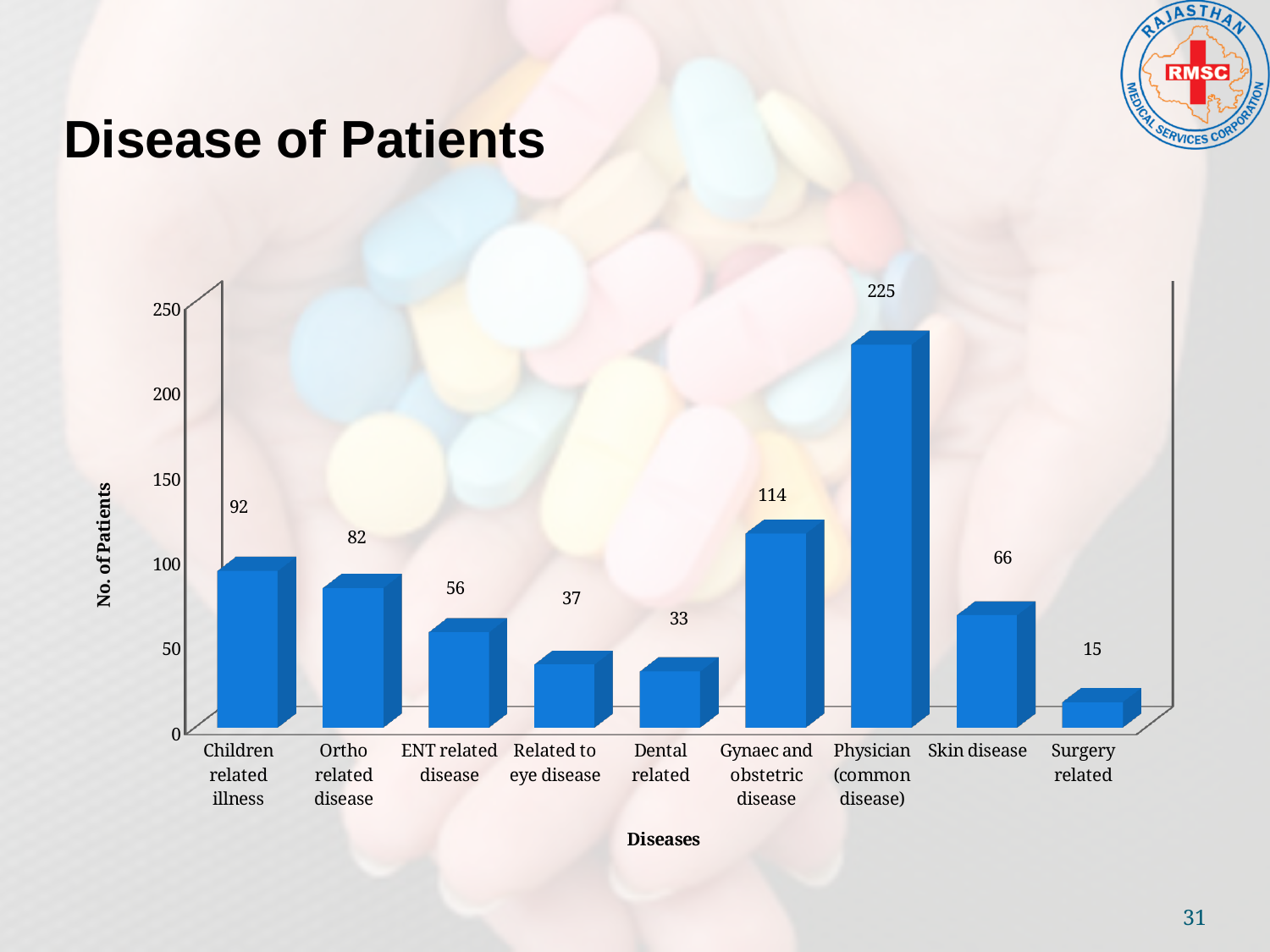
How many patients had a physician (common disease) condition? 225 What kind of chart is shown on the slide? Bar chart Is the value for dental related greater or less than 50? less What is the label of the vertical axis? No. of Patients What is the number of patients with gynaec and obstetric disease? 114 Which disease category has the lowest number of patients? Surgery related What is the value for surgery related? 15 Which has more patients, skin disease or ENT related disease? Skin disease What is the difference in number of patients between children related illness and ortho related disease? 10 How many disease categories are shown on the x axis? 9 What is the difference between the physician (common disease) value and the gynaec and obstetric disease value? 111 Which disease category has the highest number of patients? Physician (common disease)